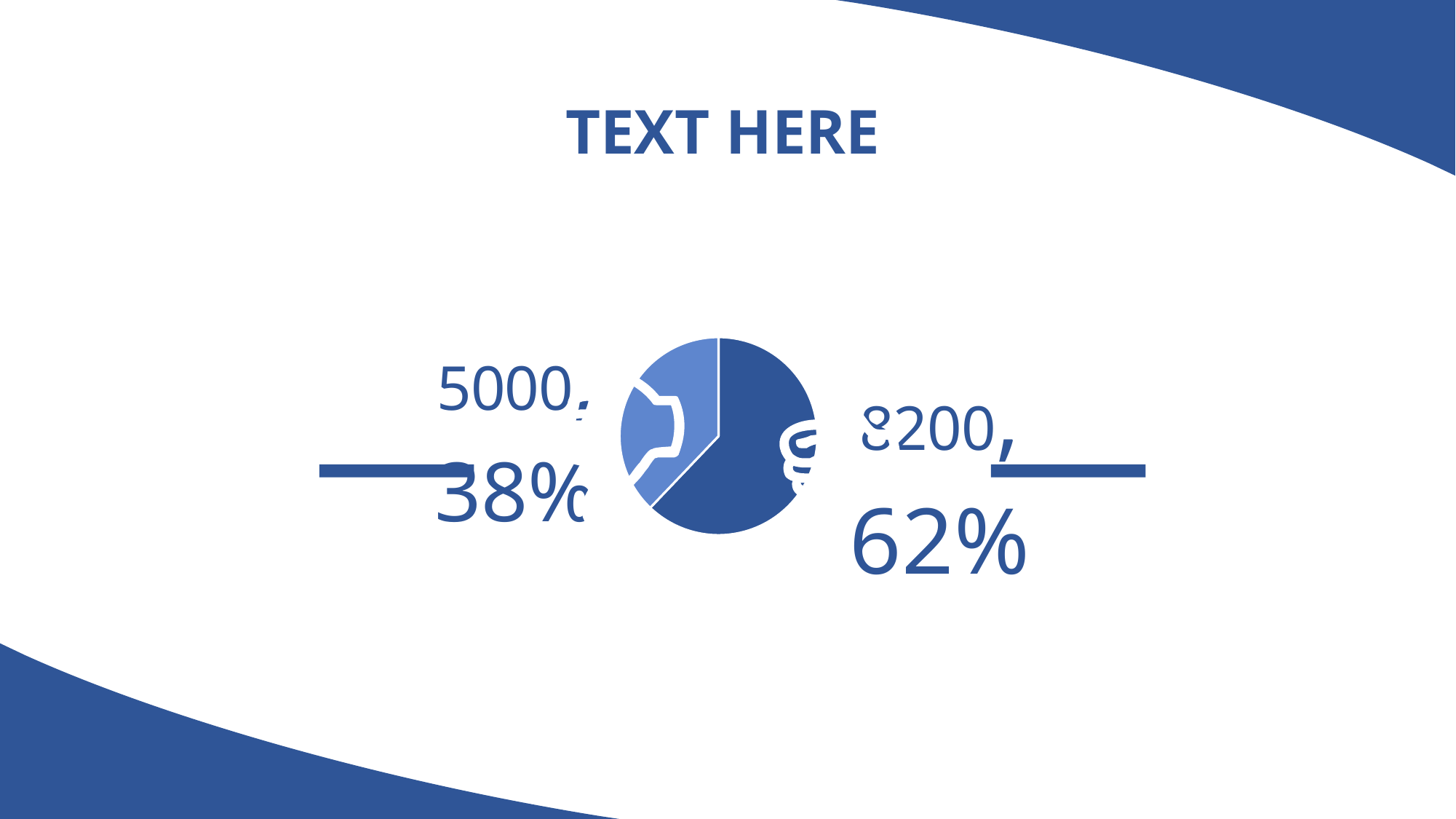
What kind of chart is shown on the slide? pie chart What is the value labelled on the larger (dark blue) slice of the pie chart? 8200 What is the total of the two slice values shown on the pie chart? 13200 What is the highest value shown on the pie chart? 8200 What percentage share does the smaller slice of the pie chart have? 38% What is the lowest value shown on the pie chart? 5000 What is the title text shown above the pie chart? TEXT HERE What is the value labelled on the smaller (light blue) slice of the pie chart? 5000 How many slices does the pie chart have? 2 What is the difference between the two slice values, 8200 and 5000? 3200 Which slice is larger: the one labelled 5000 or the one labelled 8200? 8200 What percentage share does the larger slice of the pie chart have? 62%